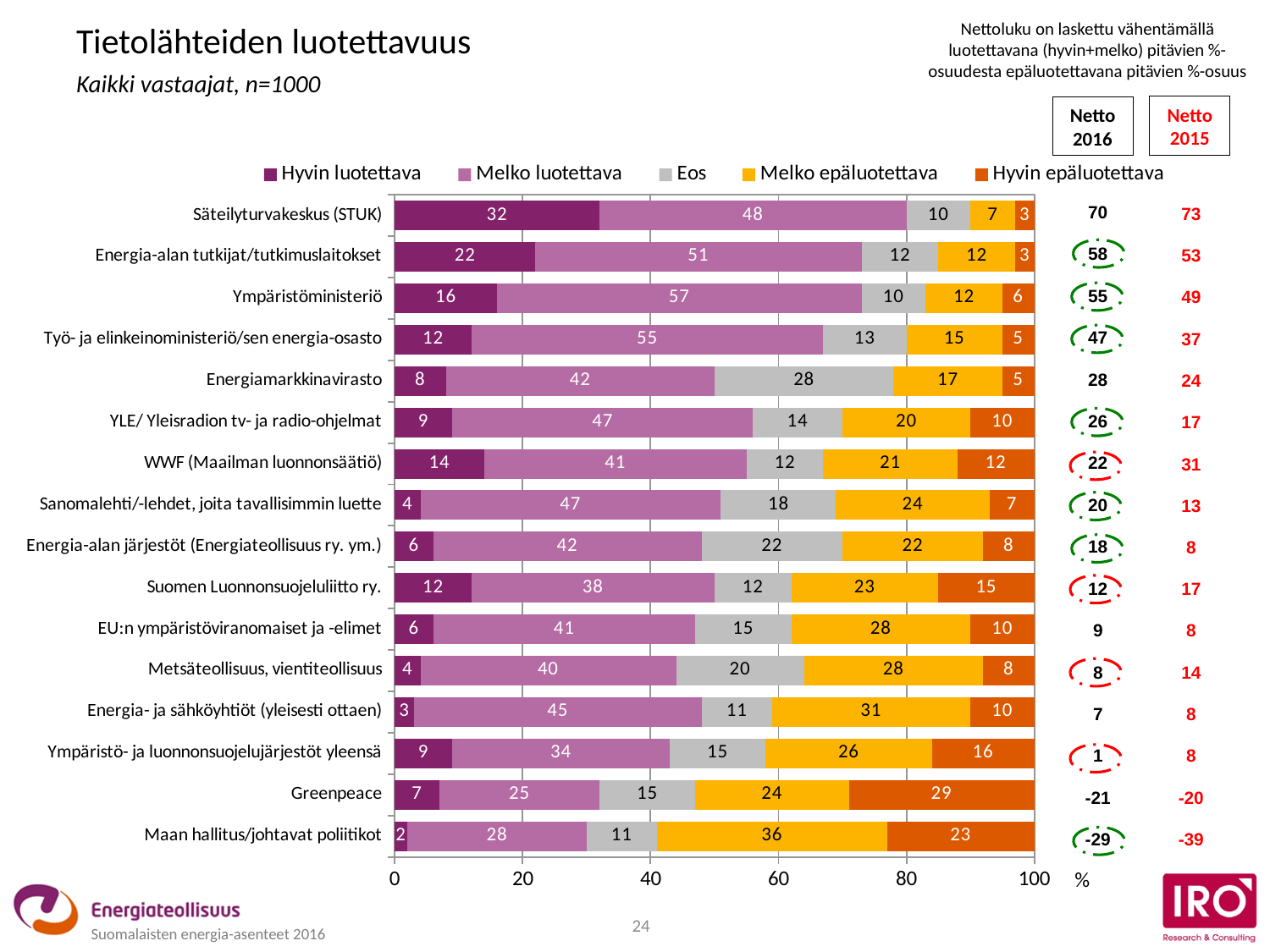
What is the 'Melko luotettava' value for Ympäristöministeriö? 57 How many series does the legend list? 5 What is the difference between the 'Melko epäluotettava' values for Maan hallitus/johtavat poliitikot and Säteilyturvakeskus (STUK)? 29 What kind of chart is shown on the slide? bar chart What is the 'Eos' value for Energiamarkkinavirasto? 28 What is the title of the chart? Tietolähteiden luotettavuus Which is larger: the 'Hyvin epäluotettava' value for WWF (Maailman luonnonsäätiö) or for YLE/ Yleisradion tv- ja radio-ohjelmat? WWF (Maailman luonnonsäätiö) Which category has the highest 'Hyvin luotettava' value? Säteilyturvakeskus (STUK) What is the 'Hyvin luotettava' value for Säteilyturvakeskus (STUK)? 32 Which category has the lowest 'Hyvin luotettava' value? Maan hallitus/johtavat poliitikot What is the 'Hyvin epäluotettava' value for Greenpeace? 29 How many categories (information sources) are plotted in the chart? 16